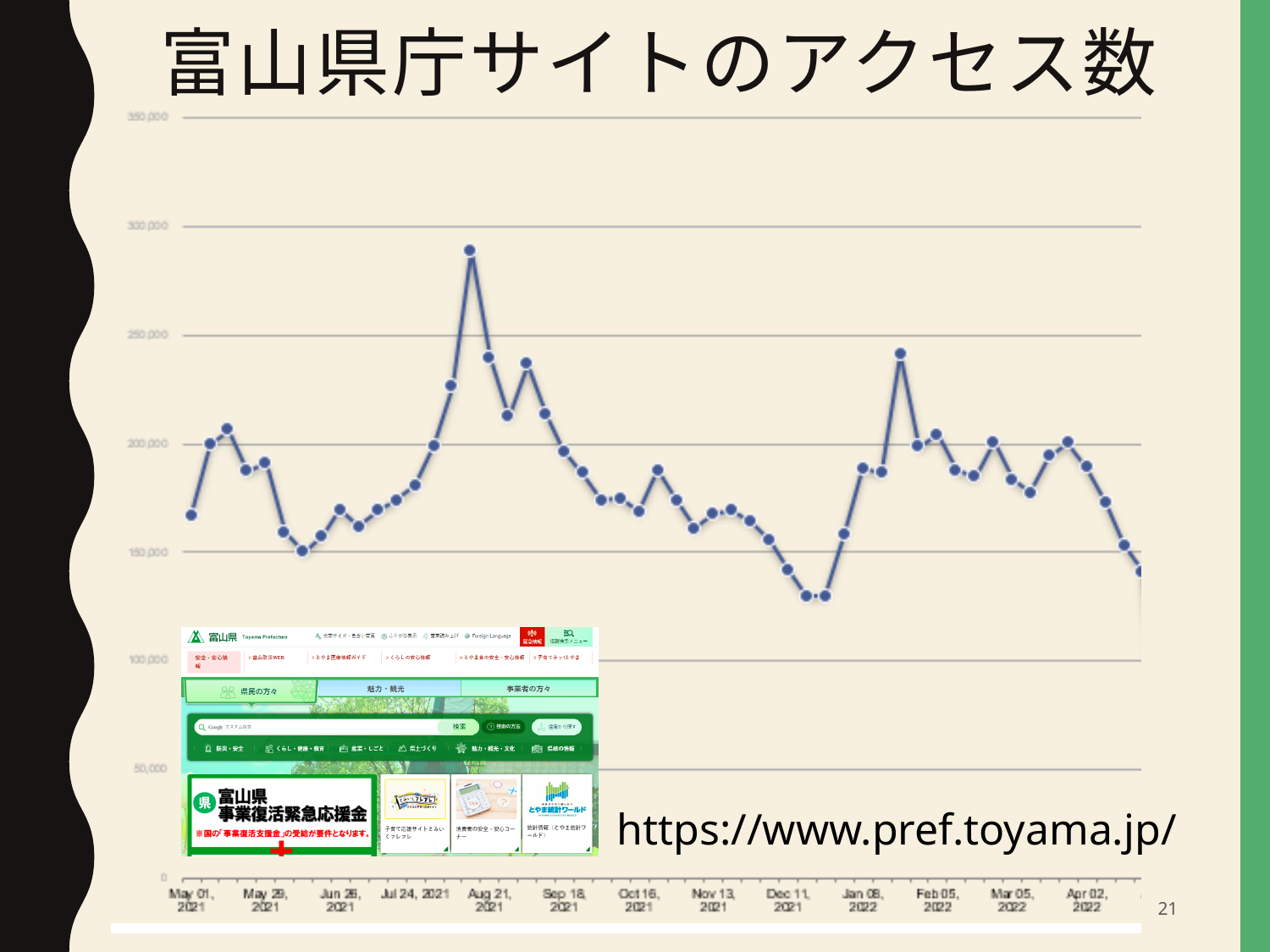
What is the title of the slide/chart? 富山県庁サイトのアクセス数 What kind of chart is shown on the slide? line chart Among the dates labeled on the x axis, which has the lowest value? Dec 11, 2021 How many date labels are shown on the x axis? 13 Is the value for May 01, 2021 greater or less than 200,000? less After Apr 02, 2022, does the line rise or fall toward the end of the chart? fall Which is larger, the value for Aug 21, 2021 or the value for Dec 11, 2021? Aug 21, 2021 Is the value for Aug 21, 2021 greater or less than 200,000? greater Is the highest point on the line greater or less than 250,000? greater Among the dates labeled on the x axis, which has the highest value? Aug 21, 2021